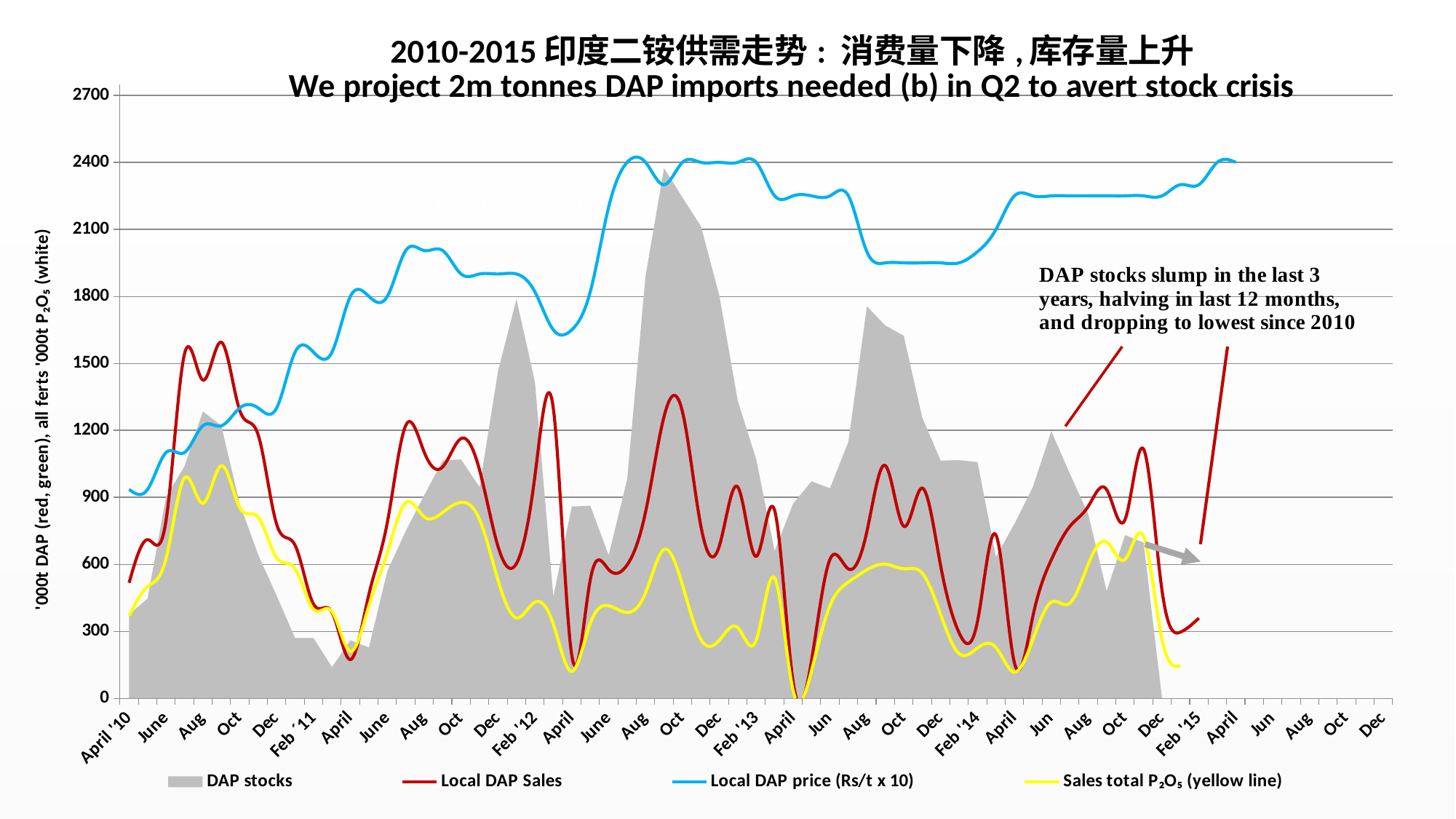
Which series is shown as the grey shaded area? DAP stocks Does the DAP stocks area rise or fall overall from Oct '12 to Dec '14? fall Is the value of DAP stocks at Oct '12 greater or less than 2100? greater Is the value of Sales total P2O5 (yellow line) at April '12 greater or less than 300? less What kind of chart is shown on the slide? combination area and line chart Is the value of Local DAP Sales at Aug '10 greater or less than 1200? greater Does the Local DAP price (Rs/t x 10) line rise or fall overall from April '10 to Aug '12? rise Which series is drawn as the blue line? Local DAP price (Rs/t x 10) How many series does the legend list? 4